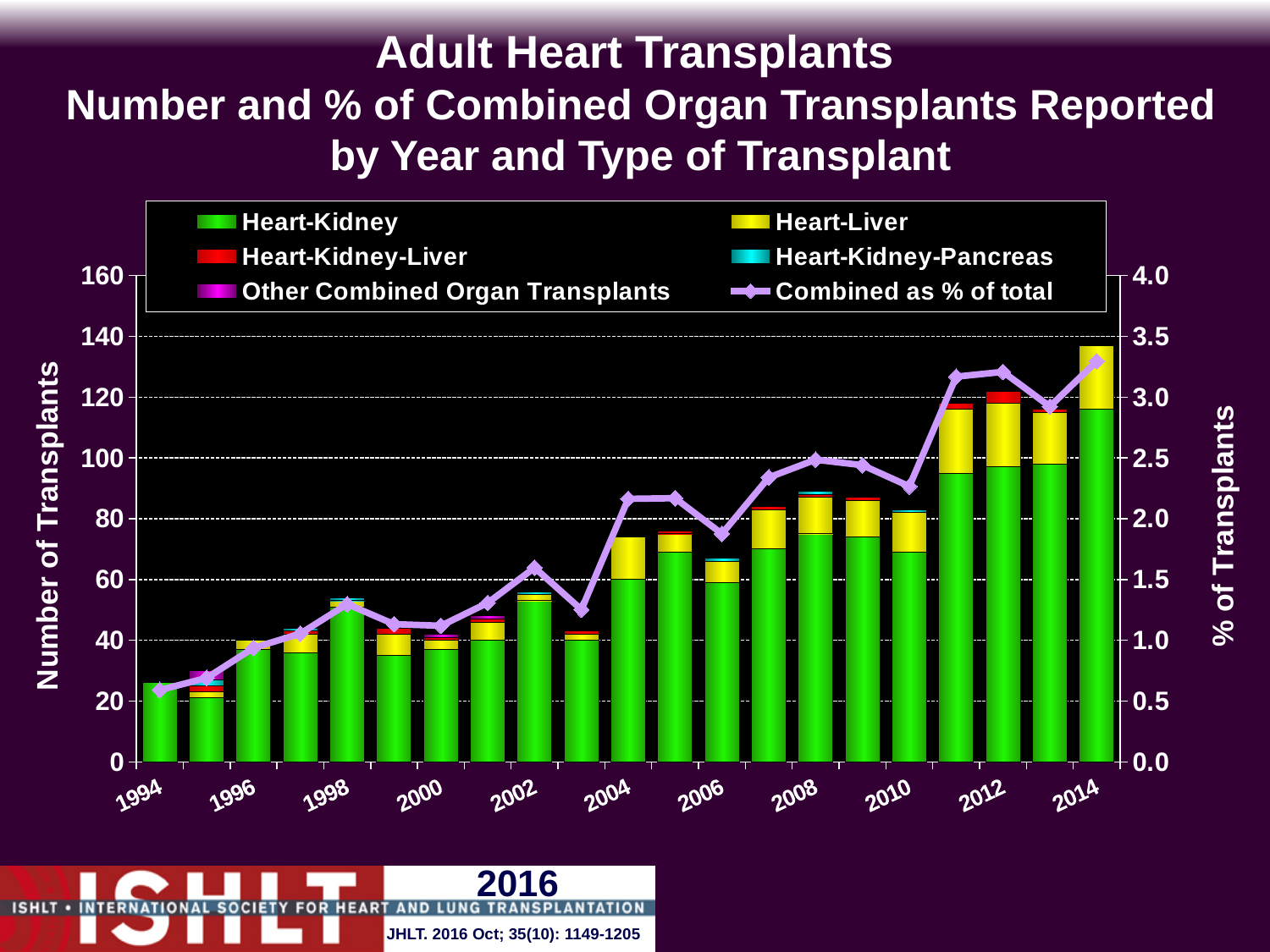
Which year has the highest total number of combined organ transplants? 2014 What is the label of the right-hand vertical axis? % of Transplants Which year has the lowest total number of combined organ transplants? 1994 How many years (bars) are plotted along the x axis? 21 Overall, does the total number of combined organ transplants rise or fall from 1994 to 2014? rise Which year has a larger total number of transplants, 2004 or 2012? 2012 Is the 'Combined as % of total' value for 2014 greater or less than 3.0? greater Is the total number of transplants for 1994 greater or less than 40? less Is the 'Combined as % of total' value for 1994 greater or less than 1.0? less What kind of chart is shown on the slide? Stacked bar chart with a line overlay How many entries does the legend list? 6